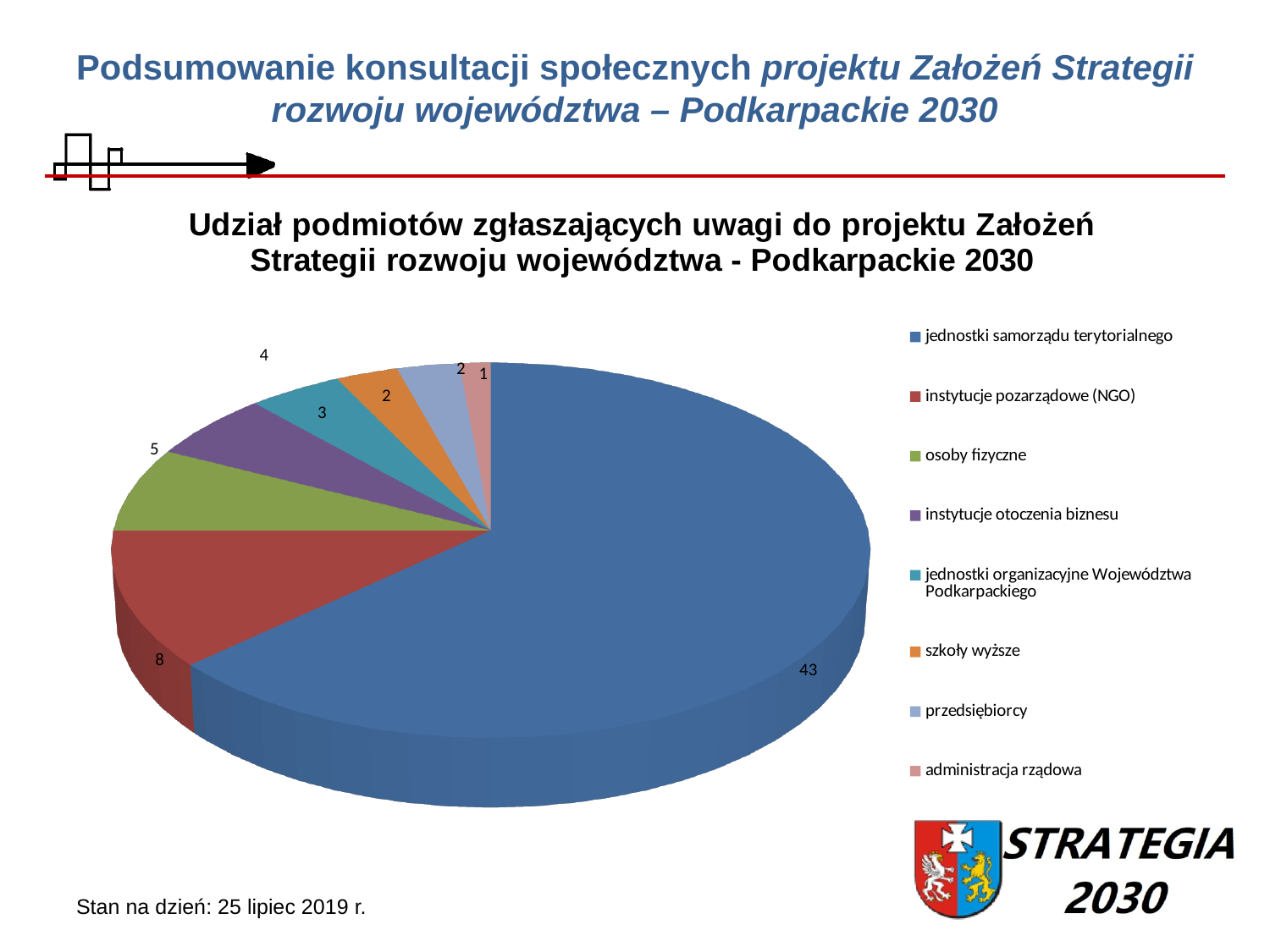
What is the value for instytucje pozarządowe (NGO)? 8 How many categories does the pie chart have? 8 Which category has the smallest slice of the pie? administracja rządowa What is the value for osoby fizyczne? 5 What is the value for jednostki samorządu terytorialnego? 43 Which category has the largest slice of the pie? jednostki samorządu terytorialnego What is the value for administracja rządowa? 1 What kind of chart is shown on the slide? pie chart Which is larger, the value for osoby fizyczne or the value for jednostki organizacyjne Województwa Podkarpackiego? osoby fizyczne What is the title of the chart? Udział podmiotów zgłaszających uwagi do projektu Założeń Strategii rozwoju województwa - Podkarpackie 2030 What is the value for instytucje otoczenia biznesu? 4 What is the difference between the values for jednostki samorządu terytorialnego and instytucje pozarządowe (NGO)? 35